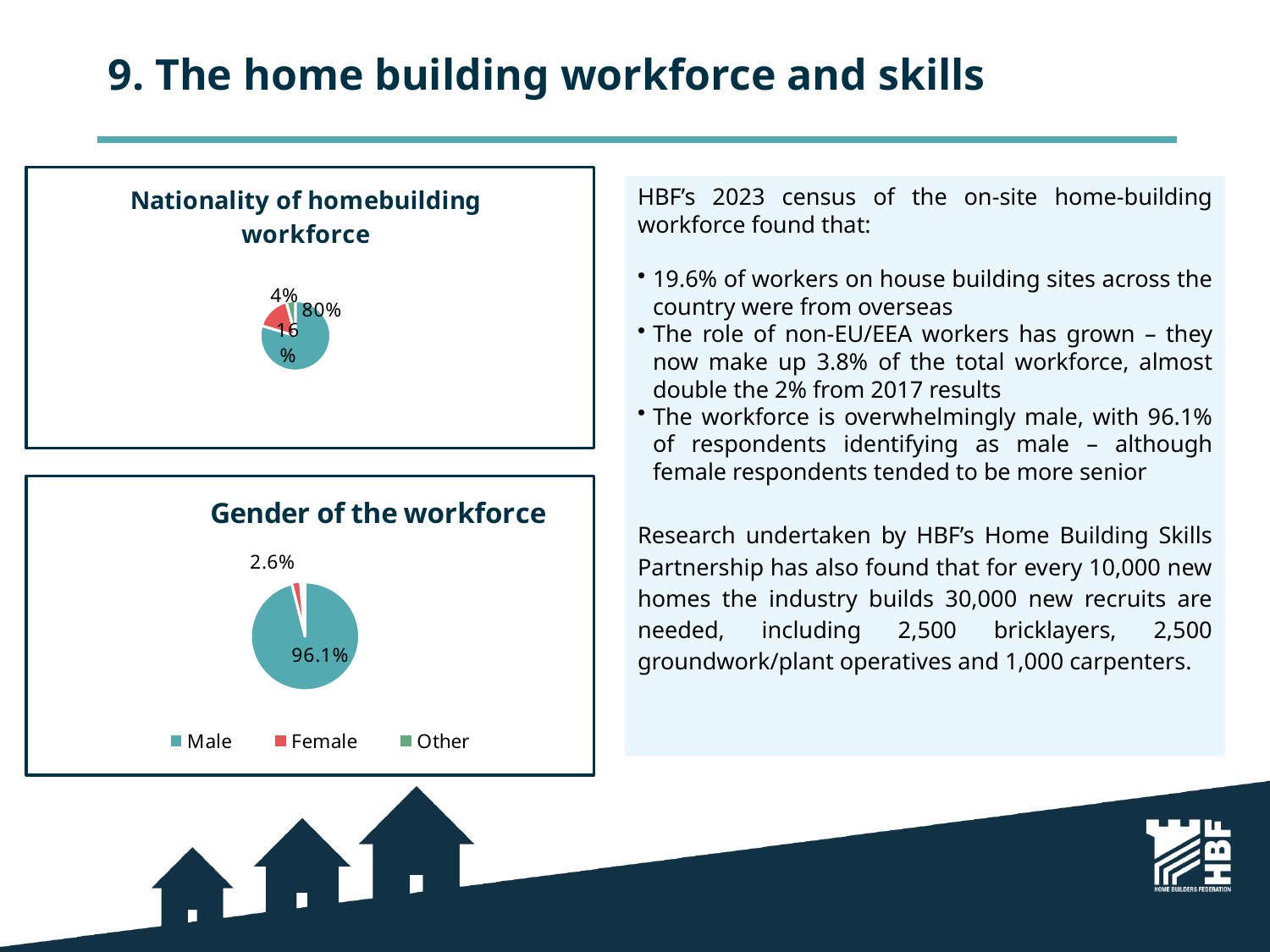
In the 'Gender of the workforce' chart, what share of the workforce is Male? 96.1% In the 'Gender of the workforce' chart, how many entries does the legend list? 3 In the 'Nationality of homebuilding workforce' chart, what is the value of the smallest slice? 4% In the 'Gender of the workforce' chart, what colour represents Female in the legend? Red In the 'Gender of the workforce' chart, which is larger, the Male slice or the Female slice? Male In the 'Gender of the workforce' chart, what share of the workforce is Female? 2.6% In the 'Gender of the workforce' chart, which category has the largest slice? Male In the 'Gender of the workforce' chart, what is the difference between the Male and Female shares? 93.5% In the 'Nationality of homebuilding workforce' chart, what is the value of the largest slice? 80% How many slices does the 'Nationality of homebuilding workforce' pie chart have? 3 What kind of chart is 'Gender of the workforce'? Pie chart What kind of chart is 'Nationality of homebuilding workforce'? Pie chart